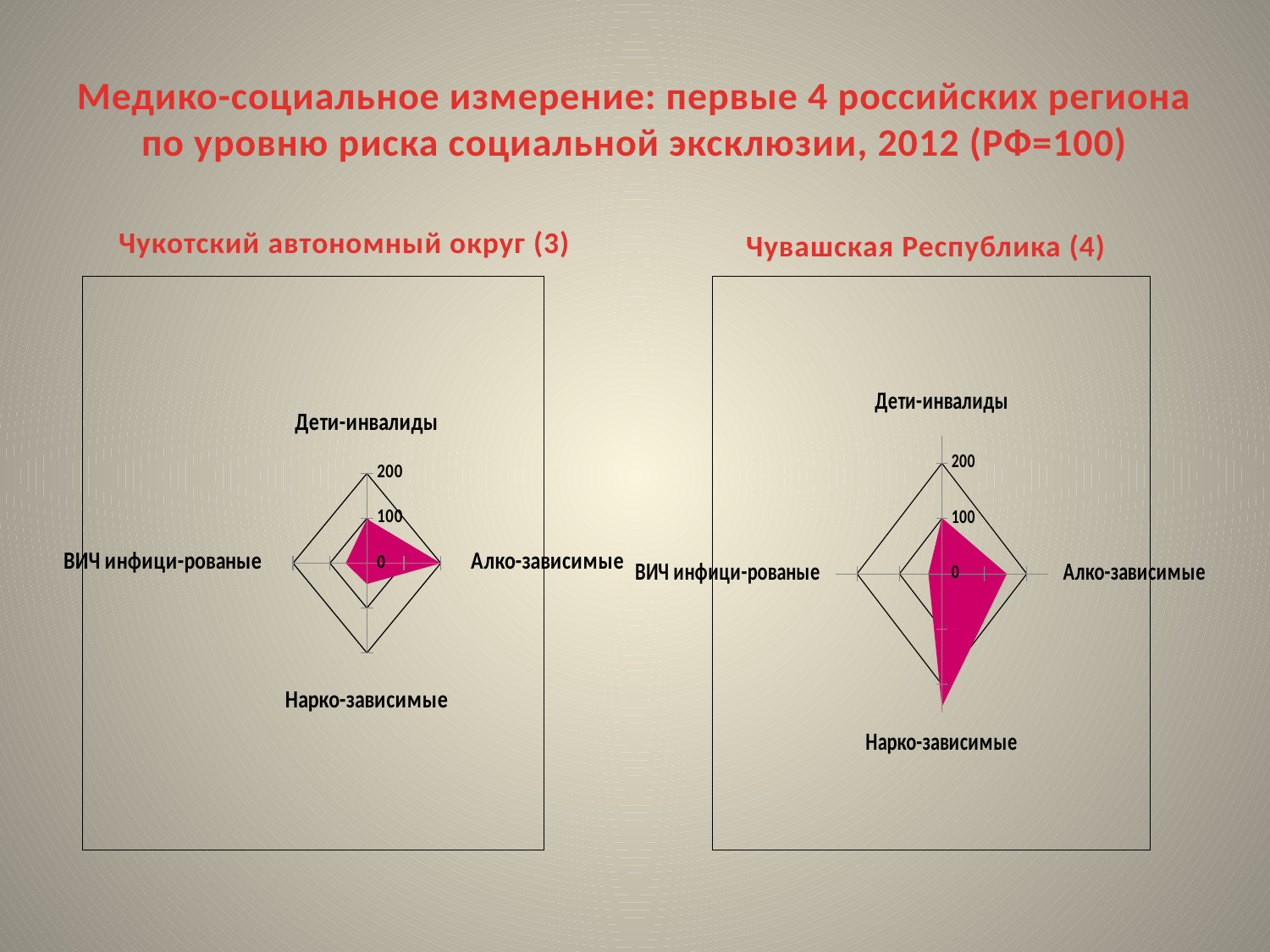
In the Чувашская Республика (4) chart, which category has the lowest value? ВИЧ инфици-рованые How many categories (axes) does the Чувашская Республика (4) chart have? 4 In the Чукотский автономный округ (3) chart, is the value for Нарко-зависимые greater or less than 100? less In the Чувашская Республика (4) chart, which category has the highest value? Нарко-зависимые In the Чукотский автономный округ (3) chart, which category has the highest value? Алко-зависимые In the Чукотский автономный округ (3) chart, is the value for Алко-зависимые greater or less than 100? greater In the Чукотский автономный округ (3) chart, which is larger: Алко-зависимые or ВИЧ инфици-рованые? Алко-зависимые In the Чувашская Республика (4) chart, is the value for Нарко-зависимые greater or less than 200? greater In the Чувашская Республика (4) chart, which is larger: Нарко-зависимые or Дети-инвалиды? Нарко-зависимые What kind of chart is used for Чукотский автономный округ (3)? radar chart What is the highest axis tick label shown on the Чувашская Республика (4) chart? 200